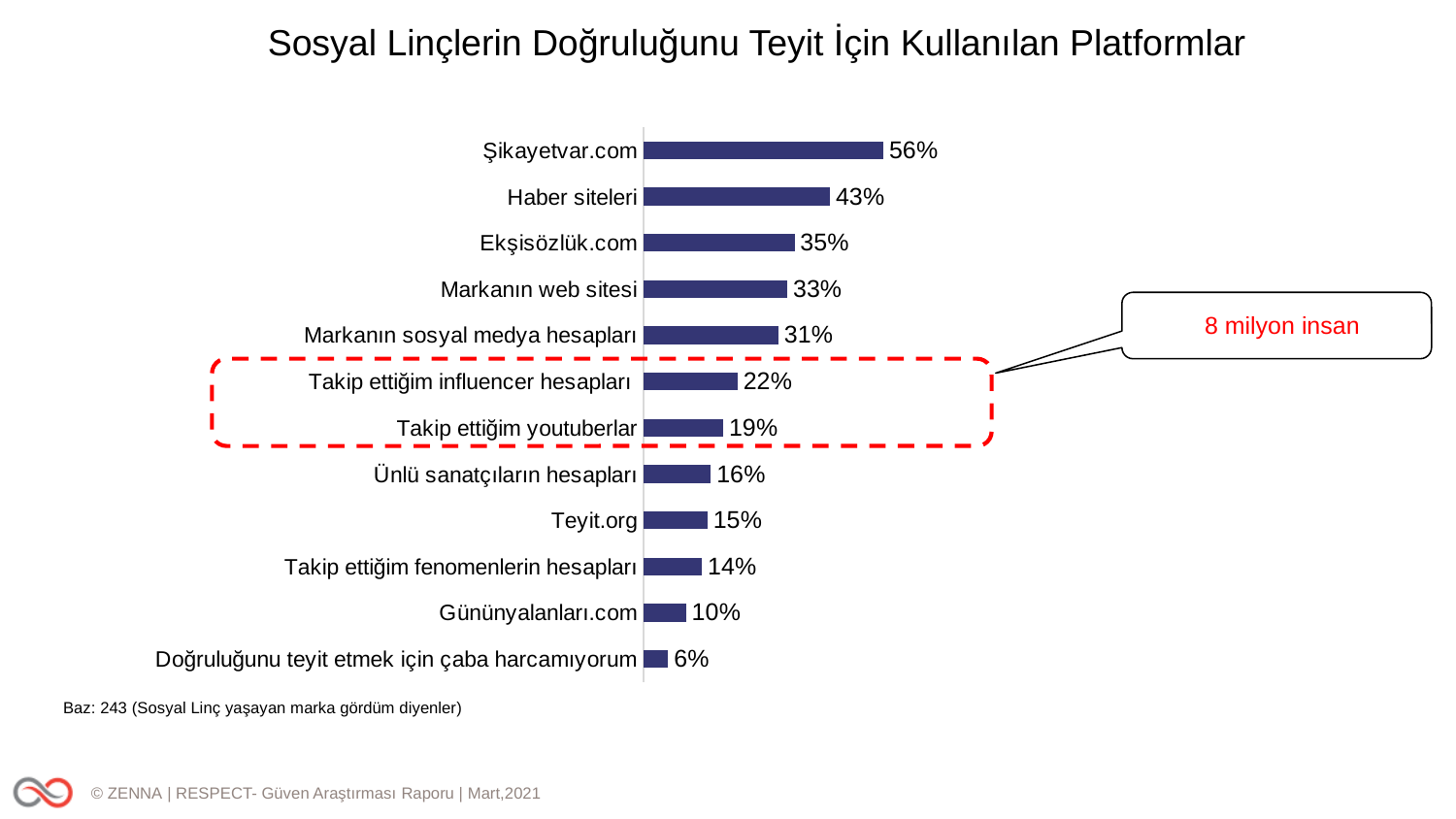
What is the value for Teyit.org? 15% What is the value for Şikayetvar.com? 56% Which category has the highest value? Şikayetvar.com What kind of chart is shown on the slide? Bar chart How many categories are shown in the chart? 12 Which is larger, the value for Ekşisözlük.com or the value for Markanın web sitesi? Ekşisözlük.com What is the title of the chart? Sosyal Linçlerin Doğruluğunu Teyit İçin Kullanılan Platformlar What is the difference between the values for Şikayetvar.com and Haber siteleri? 13% Which category has the lowest value? Doğruluğunu teyit etmek için çaba harcamıyorum What is the value for Haber siteleri? 43% What is the difference between the values for Takip ettiğim influencer hesapları and Takip ettiğim youtuberlar? 3% What is the value for Takip ettiğim youtuberlar? 19%